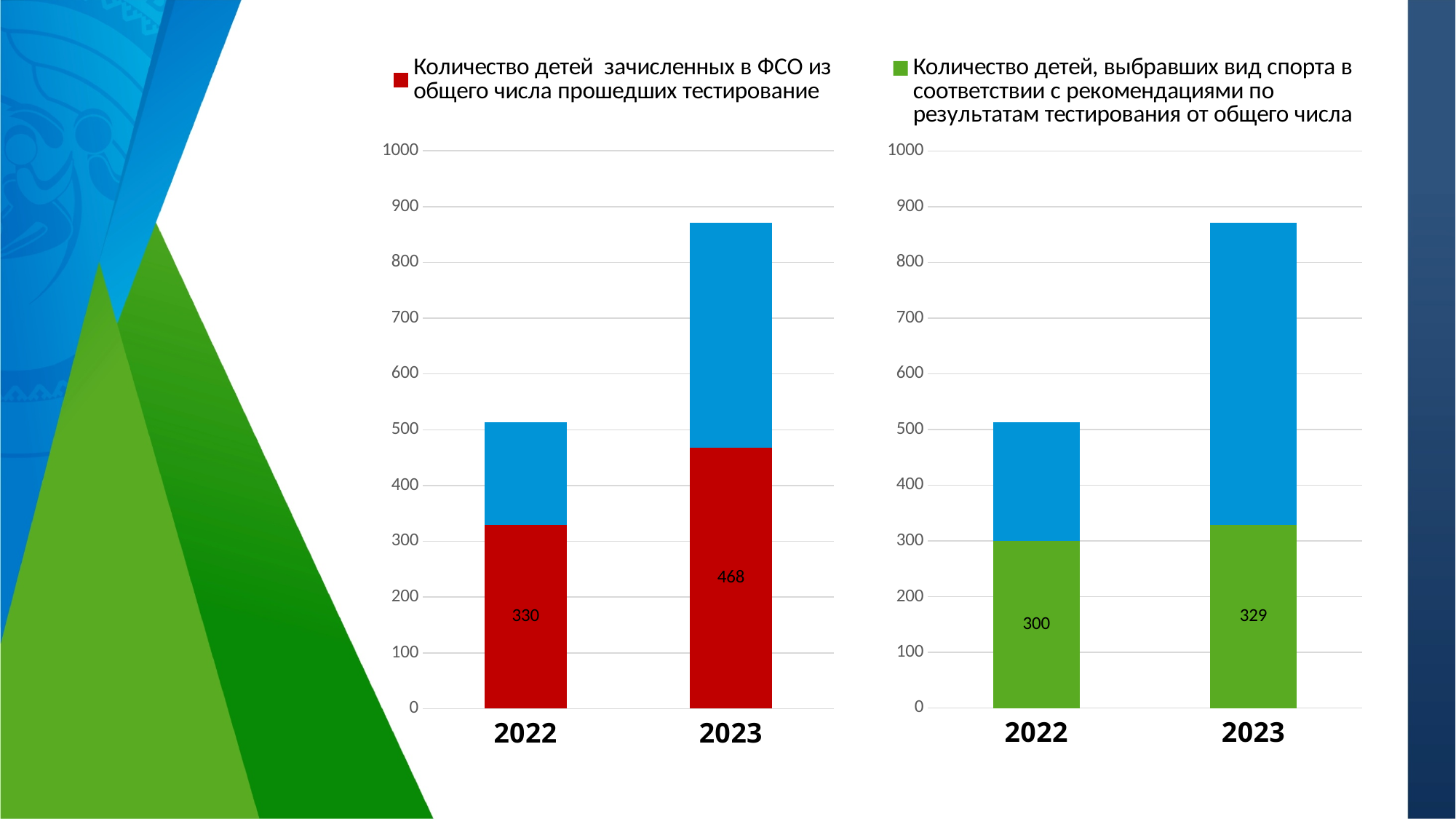
On the left chart, what is the value of the red segment for 2023? 468 On the left chart, by how much does the red segment value for 2023 exceed that for 2022? 138 On the left chart, what is the value of the red segment for 2022? 330 On the left chart, is the total height of the 2022 bar greater or less than 600? less What type of chart is the right chart? Stacked bar chart How many years are shown on the x axis of the left chart? 2 On the right chart, what is the difference between the green segment values for 2023 and 2022? 29 On the right chart, what is the value of the green segment for 2022? 300 On the left chart, which year has the larger red segment value, 2022 or 2023? 2023 On the right chart, do the green segment values rise or fall from 2022 to 2023? Rise On the right chart, is the total height of the 2023 bar greater or less than 800? greater On the right chart, what is the value of the green segment for 2023? 329